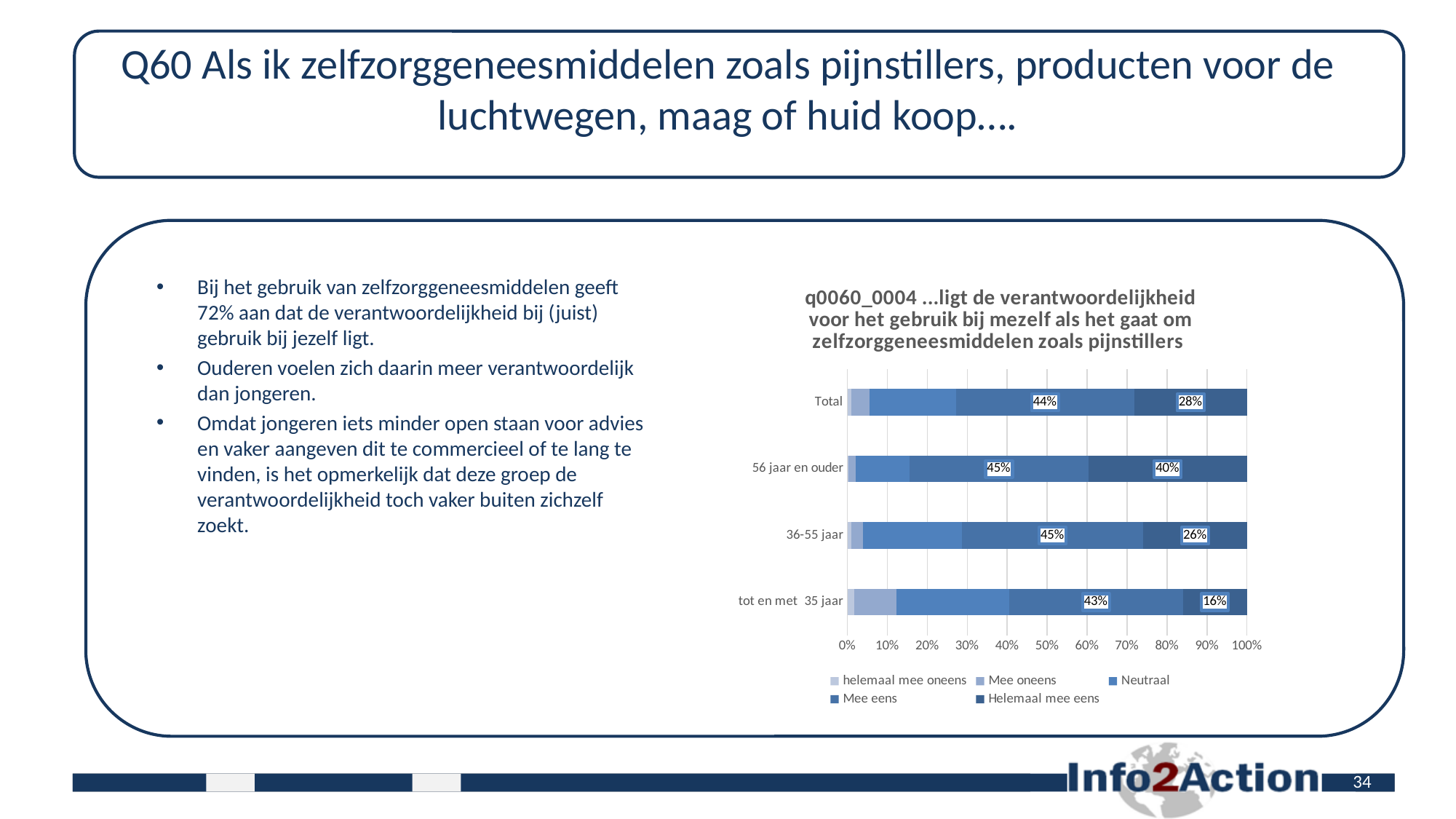
Which age group has the lowest value for 'Helemaal mee eens'? tot en met 35 jaar What is the value for 'Helemaal mee eens' for the group 'tot en met 35 jaar'? 16% Which age group has the highest value for 'Helemaal mee eens'? 56 jaar en ouder How many categories (bars) are shown in the chart? 4 What kind of chart is shown on the slide? Stacked horizontal bar chart What is the value for 'Helemaal mee eens' for the group '56 jaar en ouder'? 40% What is the difference in 'Helemaal mee eens' between '56 jaar en ouder' and 'tot en met 35 jaar'? 24 percentage points What is the value for 'Mee eens' for the group '36-55 jaar'? 45% How many series does the legend list? 5 What is the value for 'Mee eens' in the Total bar? 44% What is the combined value of 'Mee eens' and 'Helemaal mee eens' in the Total bar? 72% Which is larger: 'Helemaal mee eens' for '36-55 jaar' or for 'tot en met 35 jaar'? 36-55 jaar